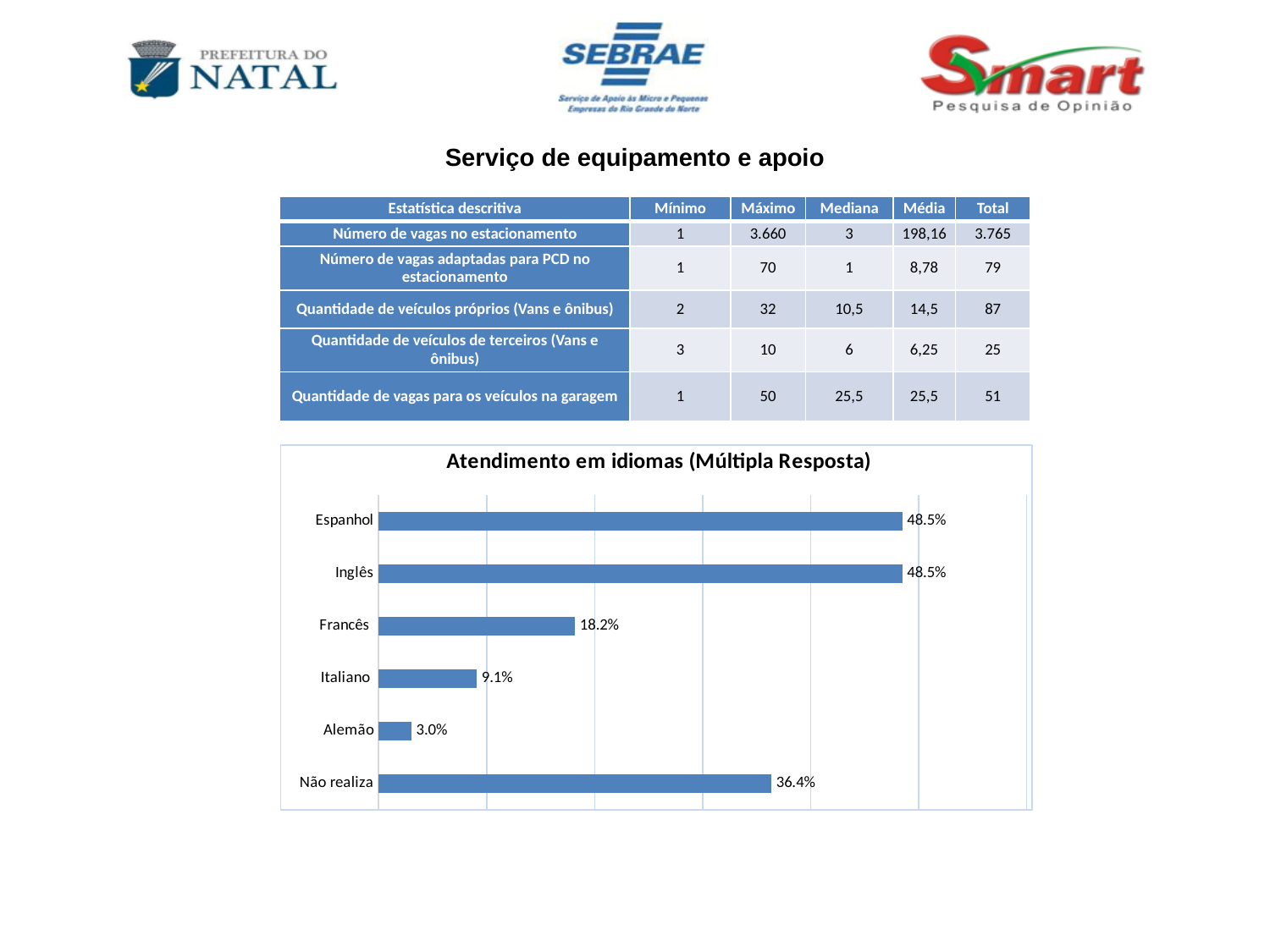
In the "Atendimento em idiomas" chart, which category has the lowest value? Alemão In the "Atendimento em idiomas" chart, how many categories are plotted? 6 In the "Atendimento em idiomas" chart, what is the difference between the values for Inglês and Francês? 30.3% What kind of chart is shown under the title "Atendimento em idiomas (Múltipla Resposta)"? bar chart In the "Atendimento em idiomas" chart, what is the value for Espanhol? 48.5% In the "Atendimento em idiomas" chart, what is the value for Francês? 18.2% What is the title of the bar chart on the slide? Atendimento em idiomas (Múltipla Resposta) In the "Atendimento em idiomas" chart, what is the value for Não realiza? 36.4% In the "Atendimento em idiomas" chart, which is larger, the value for Francês or the value for Não realiza? Não realiza In the "Atendimento em idiomas" chart, what is the value for Italiano? 9.1% In the "Atendimento em idiomas" chart, what is the difference between the values for Italiano and Alemão? 6.1% In the "Atendimento em idiomas" chart, what is the value for Alemão? 3.0%